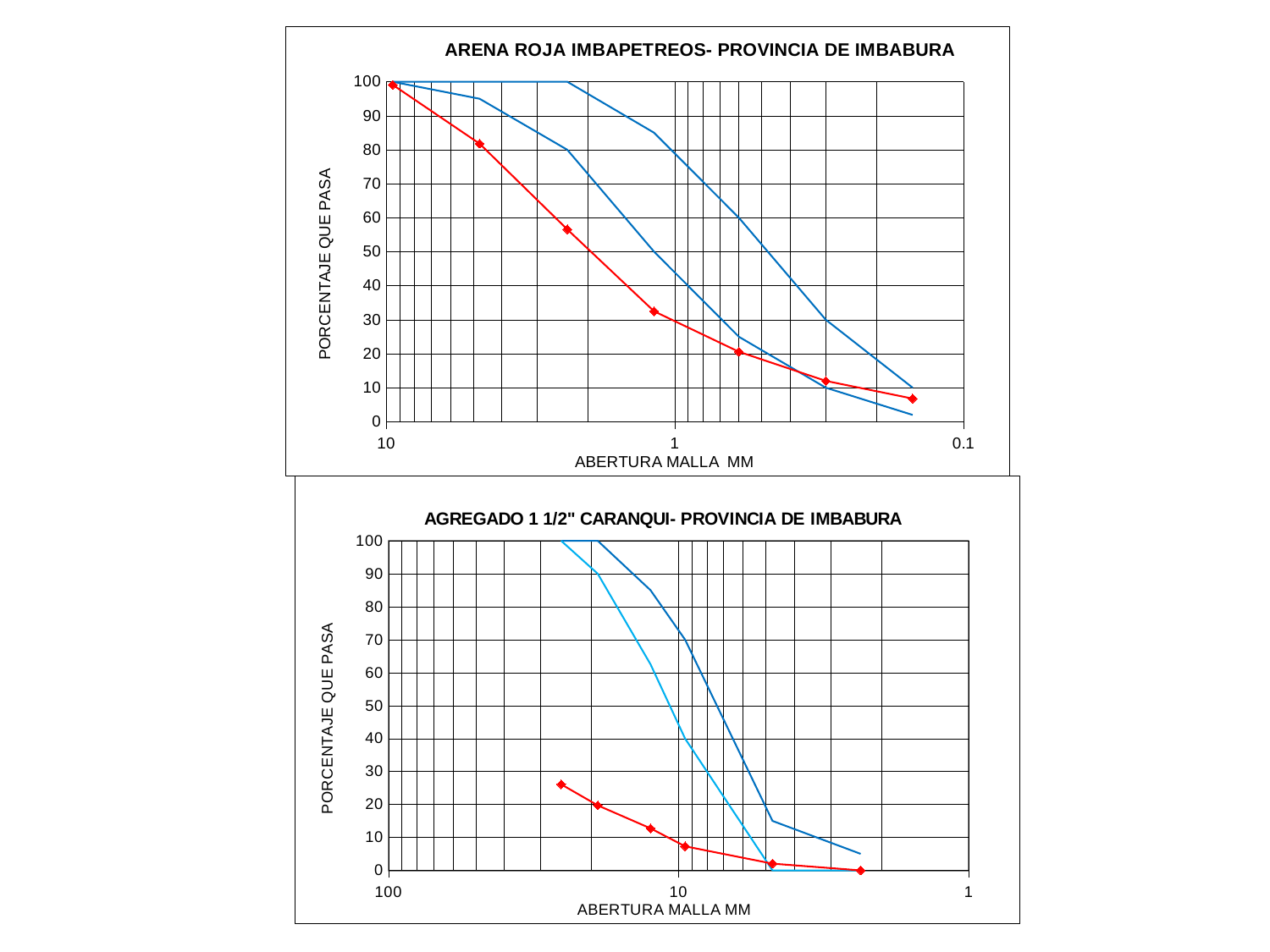
In the bottom chart, is the value of the red line at its leftmost point greater or less than 30? less In the top chart, how many marked data points does the red line have? 7 In the bottom chart, do the values of the red line rise or fall moving from left to right along the x axis? Fall In the top chart, what is the label of the vertical axis? PORCENTAJE QUE PASA In the bottom chart, what is the label of the horizontal axis? ABERTURA MALLA MM What kind of chart is the bottom chart titled 'AGREGADO 1 1/2" CARANQUI- PROVINCIA DE IMBABURA'? Line chart In the bottom chart, how many marked data points does the red line have? 6 In the bottom chart, how many lines are plotted? 3 In the top chart, is the value of the red line at its leftmost point (10 mm) greater or less than 90? greater What kind of chart is the top chart titled 'ARENA ROJA IMBAPETREOS- PROVINCIA DE IMBABURA'? Line chart In the top chart, do the values of the red line rise or fall moving from left to right along the x axis? Fall